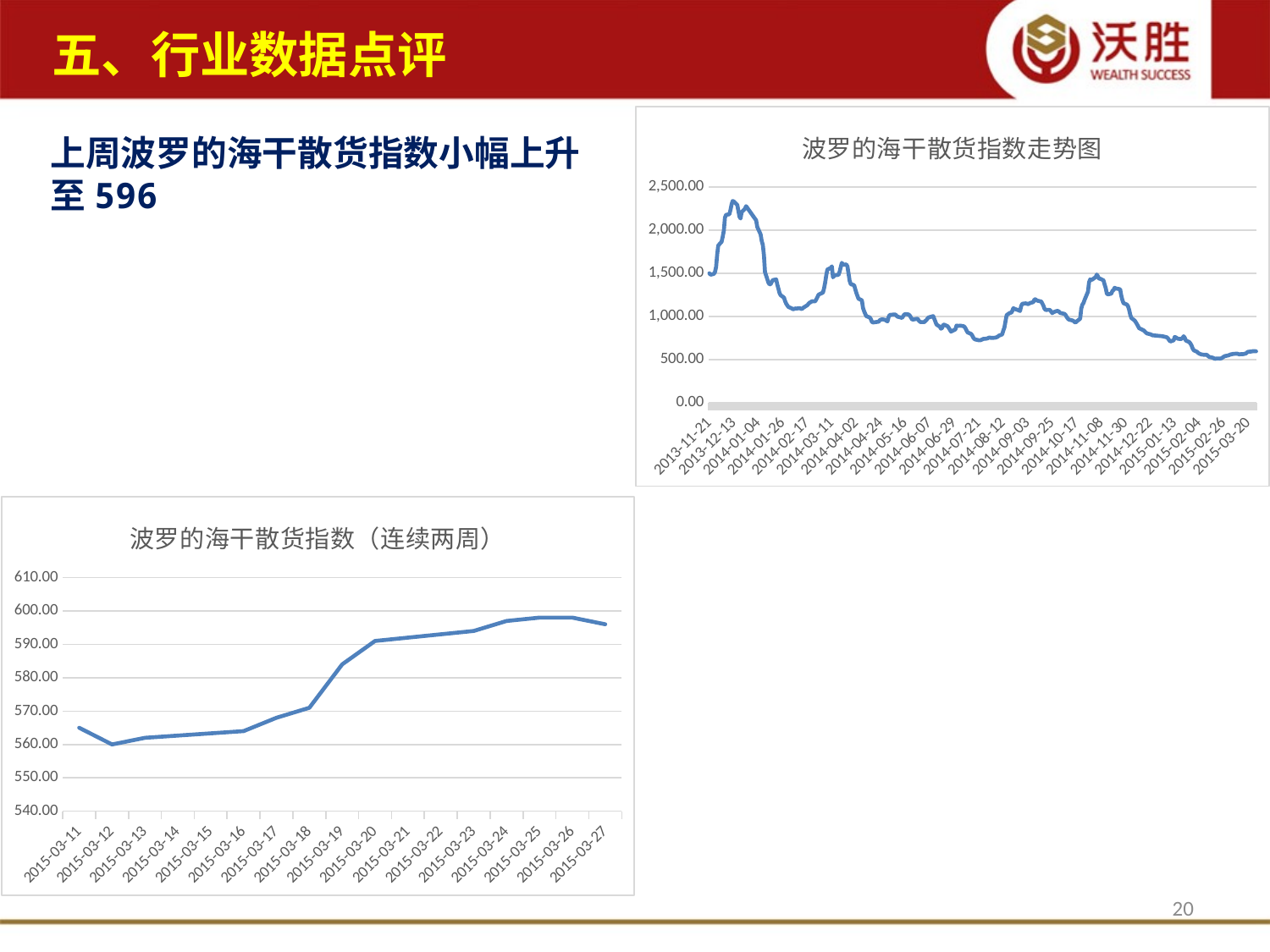
In the chart titled 波罗的海干散货指数（连续两周）, how many dates are shown on the x axis? 17 In the chart titled 波罗的海干散货指数（连续两周）, is the value for 2015-03-27 greater or less than 600.00? less What kind of chart is the chart titled 波罗的海干散货指数走势图? line chart In the chart titled 波罗的海干散货指数（连续两周）, which date has the lowest value? 2015-03-12 In the chart titled 波罗的海干散货指数走势图, is the value around 2013-12-13 greater or less than 2,000.00? greater What kind of chart is the chart titled 波罗的海干散货指数（连续两周）? line chart In the chart titled 波罗的海干散货指数走势图, is the value for 2014-07-21 greater or less than 1,000.00? less In the chart titled 波罗的海干散货指数走势图, do the values overall rise or fall from 2013-11-21 to 2015-03-20? fall In the chart titled 波罗的海干散货指数（连续两周）, which is larger, the value for 2015-03-11 or the value for 2015-03-27? 2015-03-27 In the chart titled 波罗的海干散货指数（连续两周）, do the values generally rise or fall from 2015-03-12 to 2015-03-25? rise What is the title of the chart in the top right of the slide? 波罗的海干散货指数走势图